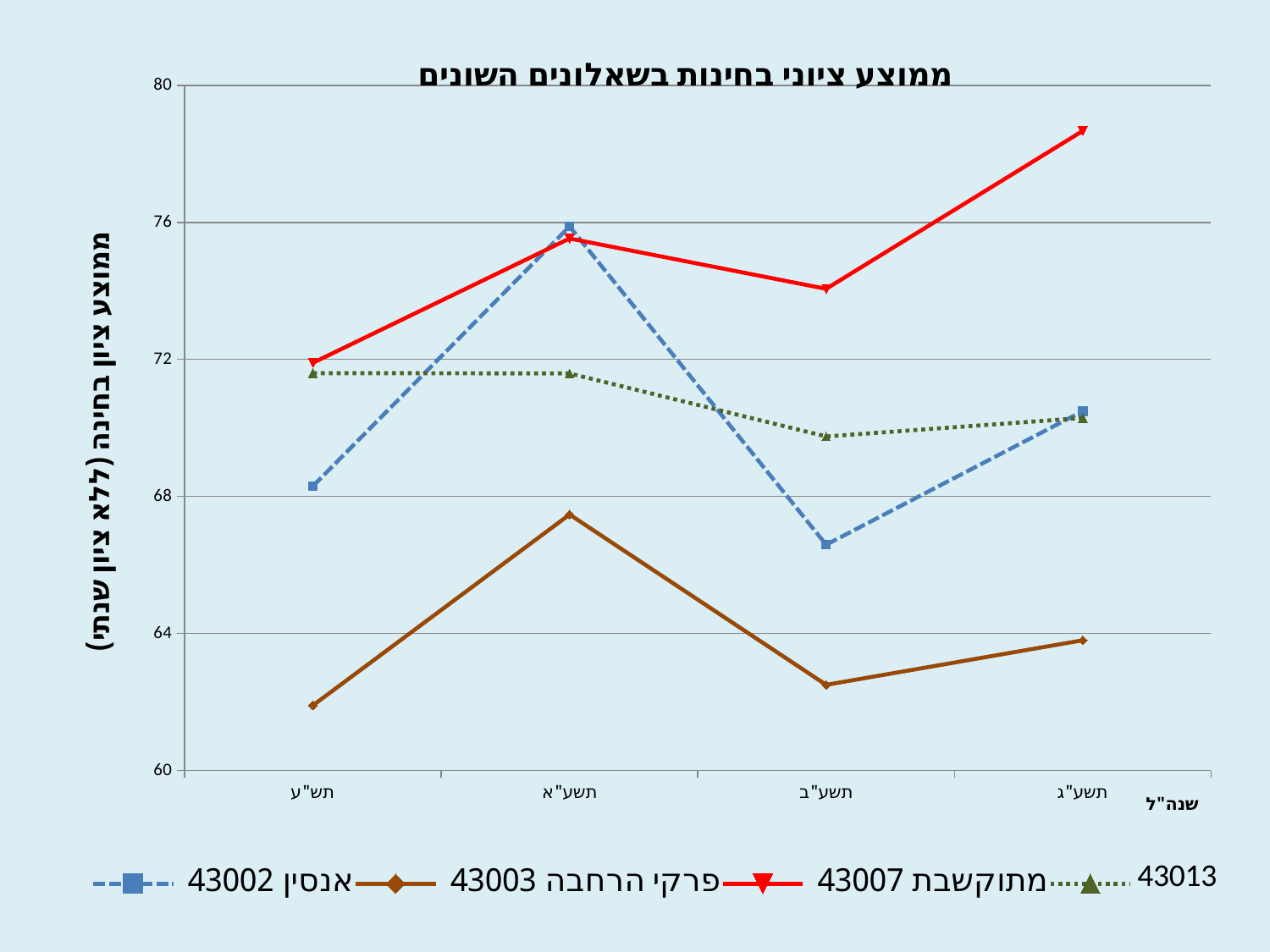
Which series has the highest value in תשע"ג? 43007 מתוקשבת Which series has the lowest value in תשע"א? 43003 פרקי הרחבה How many series does the legend list? 4 Is the value for 43002 אנסין in תשע"ב greater or less than 68? less What is the title of the chart? ממוצע ציוני בחינות בשאלונים השונים What kind of chart is shown on the slide? line chart Does the value for 43007 מתוקשבת rise or fall from תשע"ב to תשע"ג? rise In תשע"ב, which is larger: the value for 43002 אנסין or the value for 43013? 43013 Does the value for 43013 rise or fall from תשע"א to תשע"ב? fall Is the value for 43003 פרקי הרחבה in תש"ע greater or less than 64? less Is the value for 43007 מתוקשבת in תשע"ג greater or less than 76? greater How many school years are shown on the x axis? 4